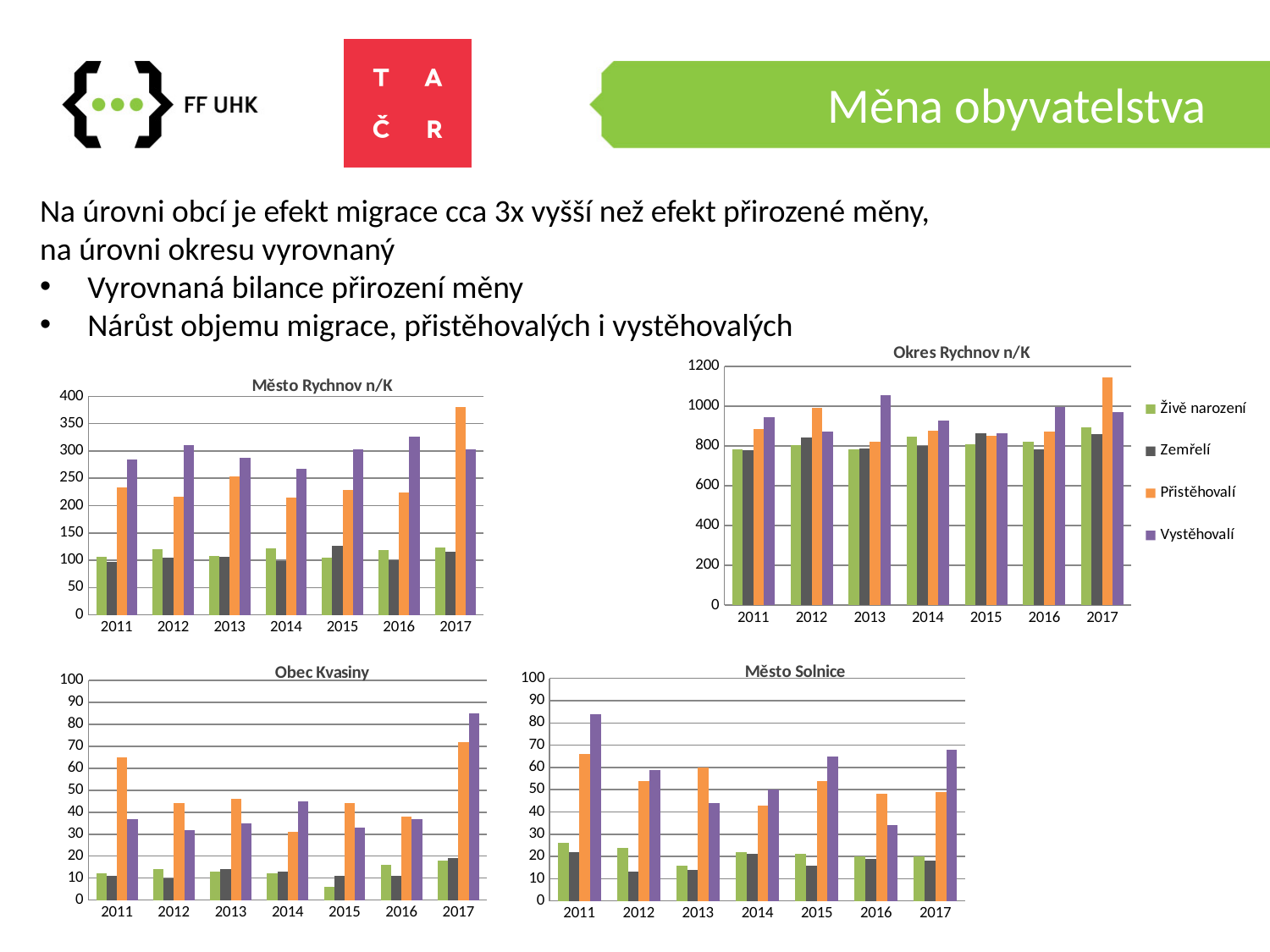
What are the legend entries of the 'Okres Rychnov n/K' chart? Živě narození, Zemřelí, Přistěhovalí, Vystěhovalí In the 'Město Rychnov n/K' chart, is the value for Přistěhovalí in 2017 greater or less than 350? greater In the 'Město Solnice' chart, which year has the highest value for Vystěhovalí? 2011 In the 'Obec Kvasiny' chart, which year has the highest value for Vystěhovalí? 2017 In the 'Město Solnice' chart, which is larger in 2011: Přistěhovalí or Vystěhovalí? Vystěhovalí In the 'Obec Kvasiny' chart, which year has the lowest value for Živě narození? 2015 How many series does the legend of the 'Okres Rychnov n/K' chart list? 4 In the 'Město Rychnov n/K' chart, which is larger in 2016: Přistěhovalí or Vystěhovalí? Vystěhovalí In the 'Okres Rychnov n/K' chart, how many years are shown on the x axis? 7 What kind of chart is the 'Město Rychnov n/K' chart? bar chart In the 'Okres Rychnov n/K' chart, is the value for Přistěhovalí in 2017 greater or less than 1000? greater In the 'Město Solnice' chart, is the value for Živě narození in 2011 greater or less than 20? greater